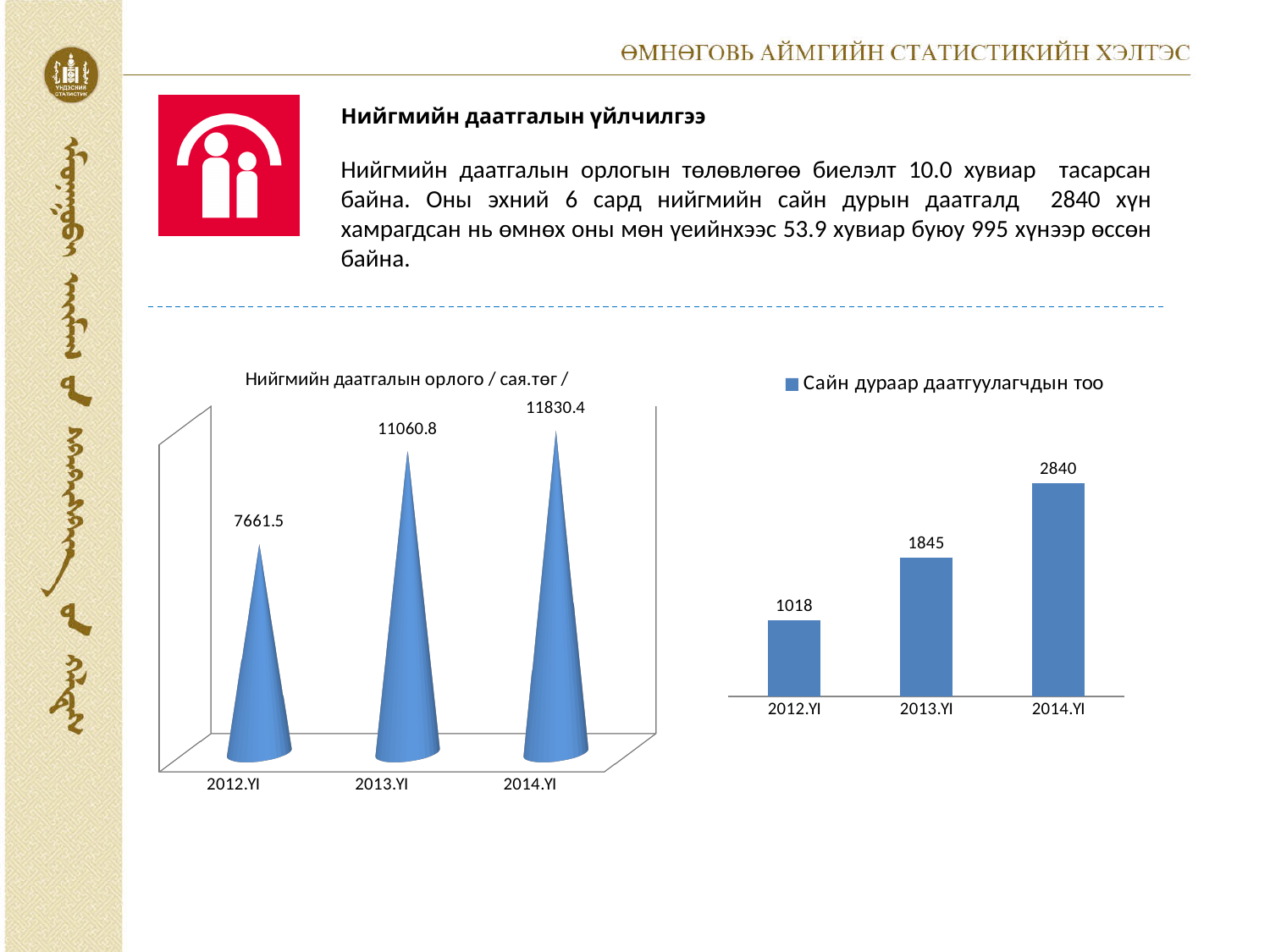
In the chart titled 'Нийгмийн даатгалын орлого / сая.төг /', what is the difference between the 2013.YI and 2012.YI values? 3399.3 In the chart titled 'Нийгмийн даатгалын орлого / сая.төг /', do the values rise or fall from 2012.YI to 2014.YI? rise What kind of chart is the right-hand chart with legend 'Сайн дураар даатгуулагчдын тоо'? bar chart In the chart titled 'Нийгмийн даатгалын орлого / сая.төг /', which year has the lowest value? 2012.YI How many series does the legend of the right-hand chart list? 1 In the chart titled 'Нийгмийн даатгалын орлого / сая.төг /', how many years are plotted? 3 In the right-hand chart with legend 'Сайн дураар даатгуулагчдын тоо', what is the difference between the 2014.YI and 2012.YI values? 1822 In the right-hand chart with legend 'Сайн дураар даатгуулагчдын тоо', what is the value for 2013.YI? 1845 In the right-hand chart with legend 'Сайн дураар даатгуулагчдын тоо', which is larger, the value for 2012.YI or 2013.YI? 2013.YI In the chart titled 'Нийгмийн даатгалын орлого / сая.төг /', what is the value for 2012.YI? 7661.5 In the right-hand chart with legend 'Сайн дураар даатгуулагчдын тоо', which year has the highest value? 2014.YI In the chart titled 'Нийгмийн даатгалын орлого / сая.төг /', what is the value for 2014.YI? 11830.4